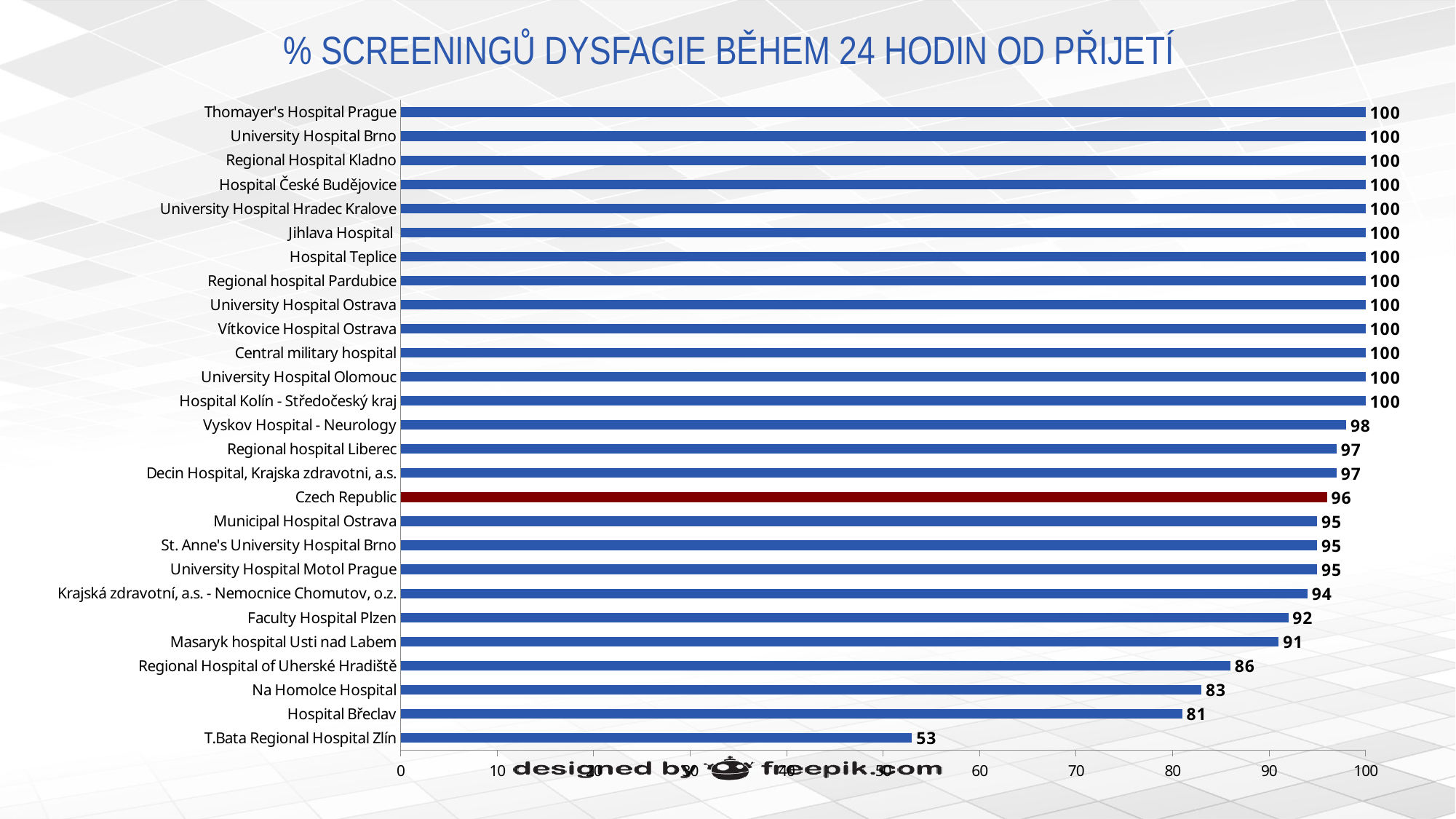
What is the value for T.Bata Regional Hospital Zlín? 53 How many categories are shown on the chart? 27 What is the value for Faculty Hospital Plzen? 92 How many hospitals have a value of 100? 13 What is the value for Vyskov Hospital - Neurology? 98 Which hospital has the lowest value? T.Bata Regional Hospital Zlín Which is larger, the value for Masaryk hospital Usti nad Labem or the value for Regional Hospital of Uherské Hradiště? Masaryk hospital Usti nad Labem Which bar is shown in a different colour (dark red) from the others? Czech Republic What is the difference between the values for Czech Republic and T.Bata Regional Hospital Zlín? 43 What kind of chart is shown on the slide? Bar chart What is the difference between the values for Na Homolce Hospital and Hospital Břeclav? 2 What is the value for Czech Republic? 96